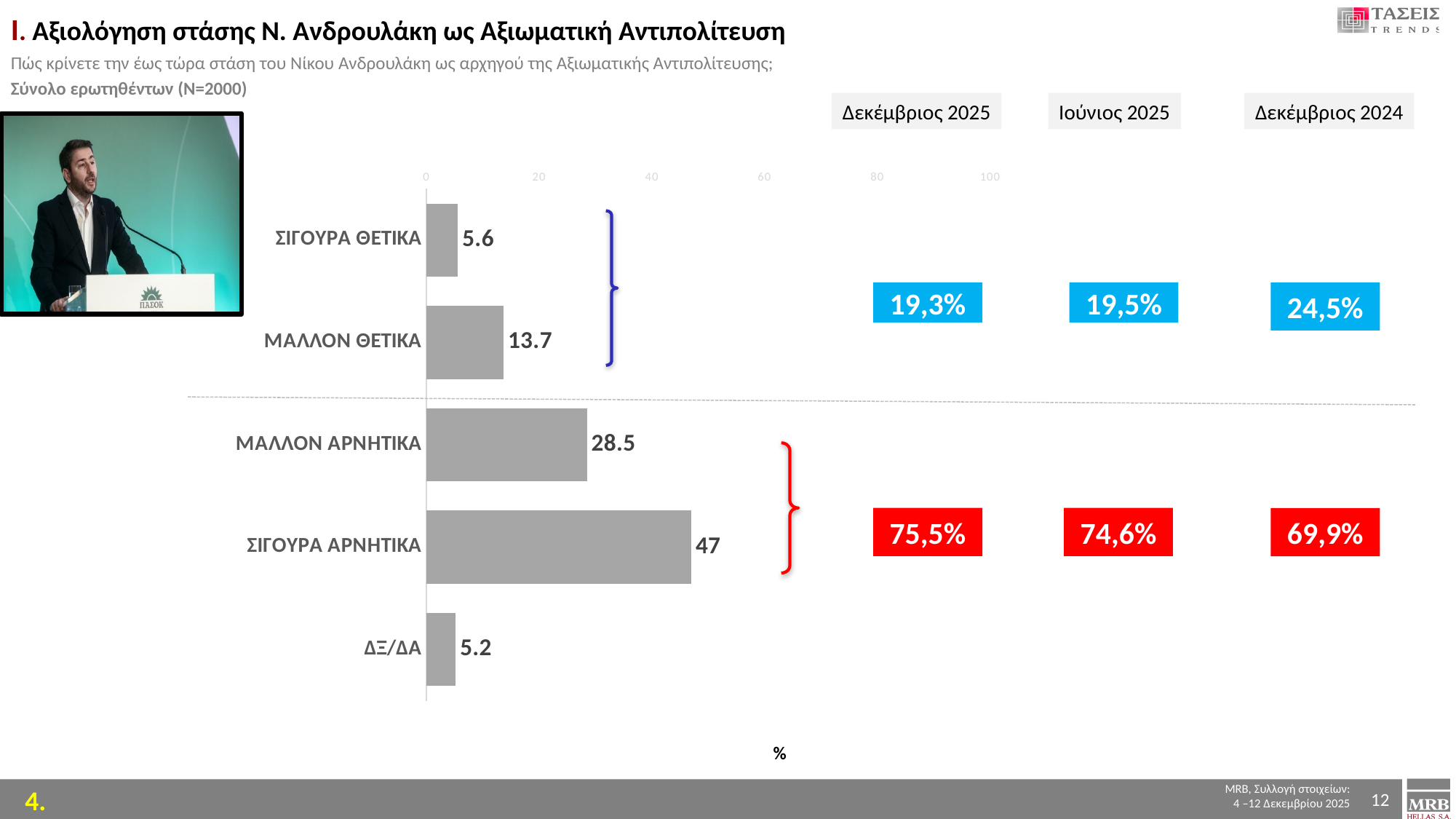
What is the value for ΣΙΓΟΥΡΑ ΑΡΝΗΤΙΚΑ in the bar chart? 47 What is the total negative (red) percentage shown for Δεκέμβριος 2025? 75,5% Which category has the lowest value in the bar chart? ΔΞ/ΔΑ Which is larger: the value for ΜΑΛΛΟΝ ΘΕΤΙΚΑ or the value for ΣΙΓΟΥΡΑ ΘΕΤΙΚΑ? ΜΑΛΛΟΝ ΘΕΤΙΚΑ What is the value for ΜΑΛΛΟΝ ΘΕΤΙΚΑ in the bar chart? 13.7 What is the value for ΔΞ/ΔΑ in the bar chart? 5.2 How many categories are shown in the bar chart? 5 What is the total positive (blue) percentage shown for Δεκέμβριος 2024? 24,5% What is the difference between the values for ΣΙΓΟΥΡΑ ΑΡΝΗΤΙΚΑ and ΜΑΛΛΟΝ ΑΡΝΗΤΙΚΑ? 18.5 Is the value for ΜΑΛΛΟΝ ΑΡΝΗΤΙΚΑ greater or less than 20? greater Which category has the highest value in the bar chart? ΣΙΓΟΥΡΑ ΑΡΝΗΤΙΚΑ What kind of chart is shown on the slide? bar chart